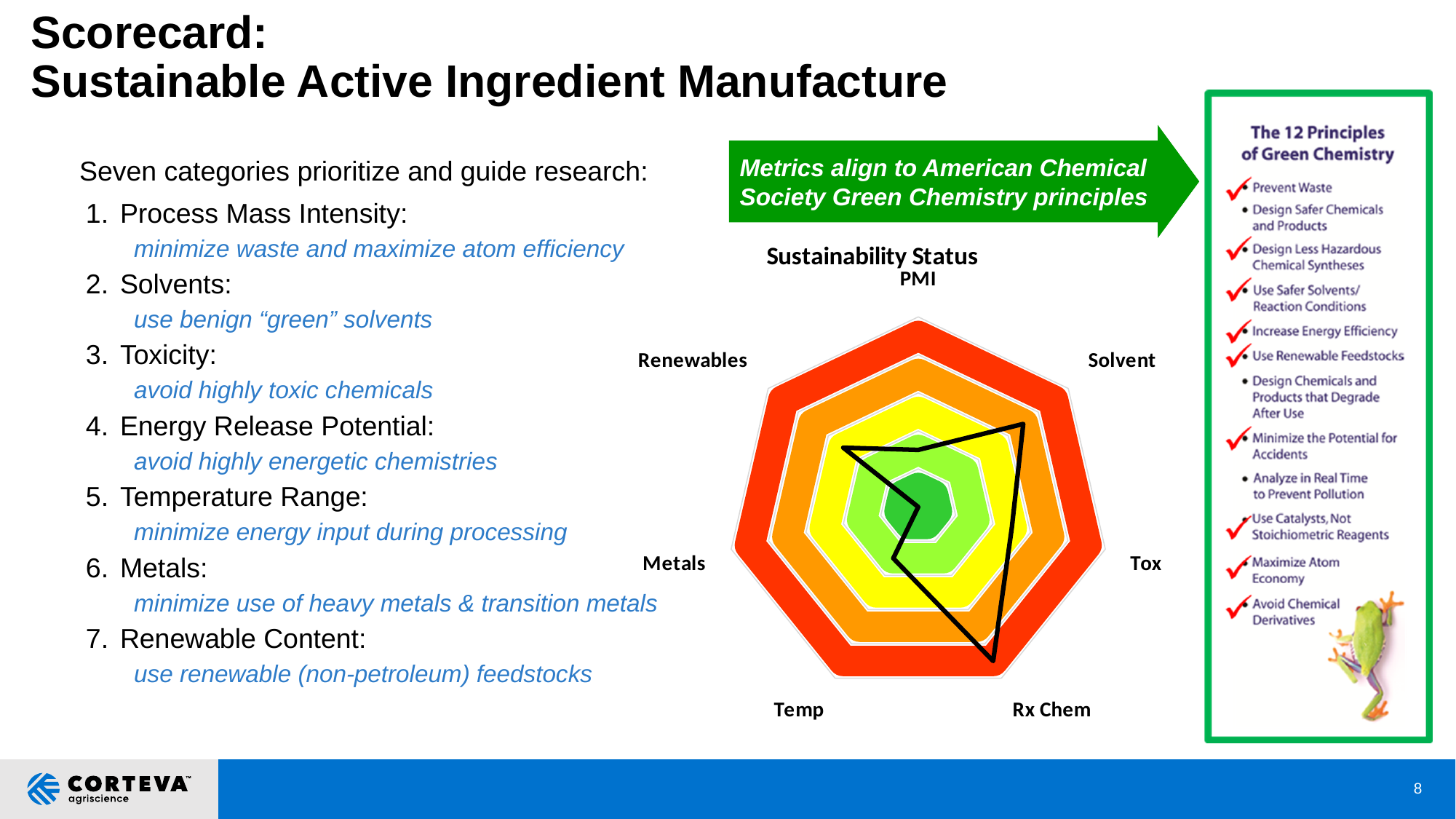
How many categories (axes) does the Sustainability Status radar chart have? 7 On the Sustainability Status radar chart, which extends farther from the center: Rx Chem or PMI? Rx Chem Which category on the Sustainability Status radar chart is positioned directly opposite Renewables, on the right side? Solvent What kind of chart is the Sustainability Status chart? Radar chart Which category label sits at the top of the Sustainability Status radar chart? PMI What is the title of the radar chart on the slide? Sustainability Status On the Sustainability Status radar chart, which extends farther from the center: Solvent or Metals? Solvent Which category on the Sustainability Status radar chart extends farthest from the center? Rx Chem